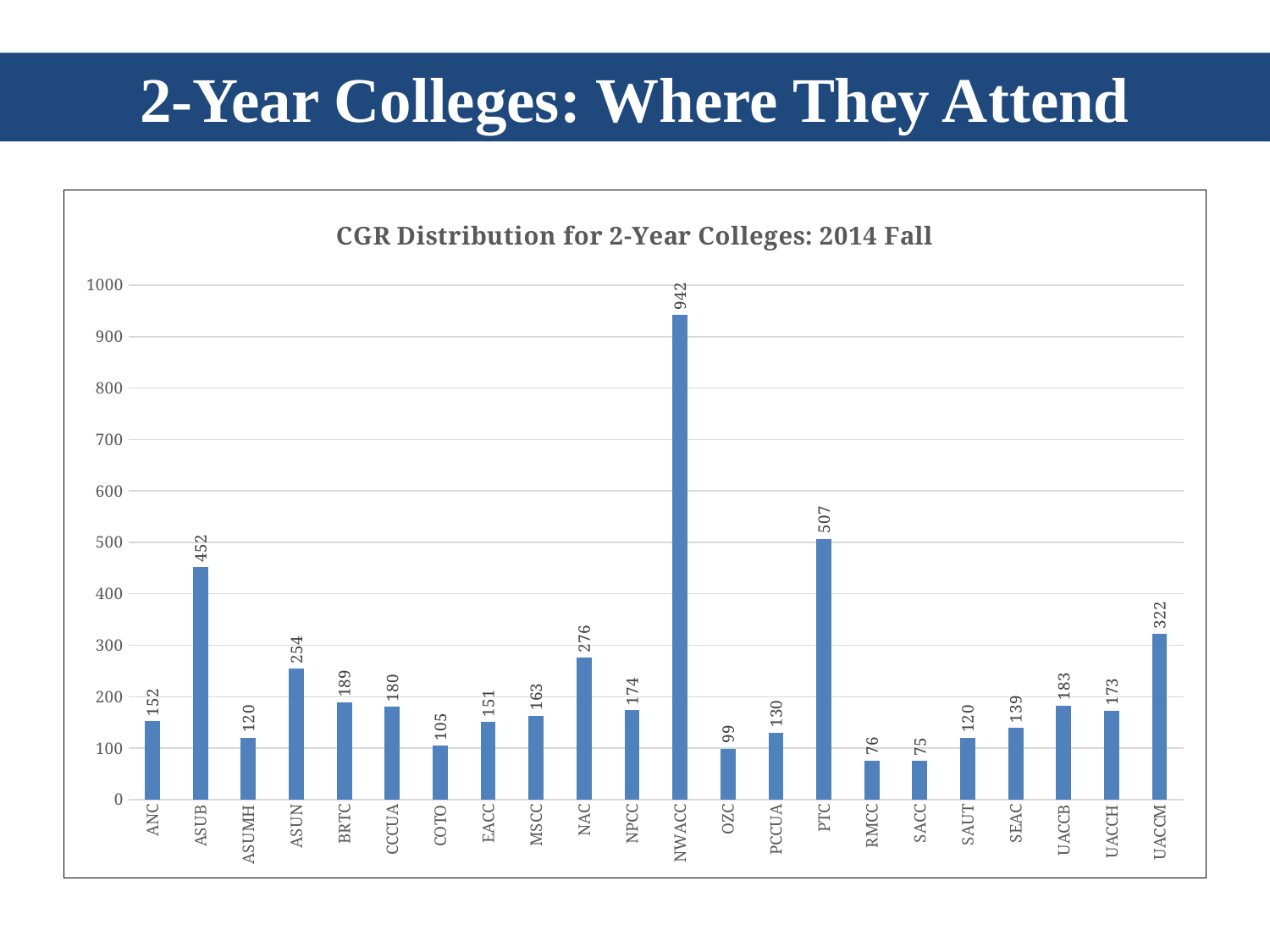
What is the value for ASUB? 452 Which is larger, the value for PTC or the value for ASUB? PTC What is the value for NWACC? 942 What kind of chart is shown? bar chart What is the difference between the values for ASUB and ASUN? 198 How many colleges are shown on the x axis? 22 What is the difference between the values for NWACC and PTC? 435 Is the value for COTO greater or less than 200? less Which college has the highest value? NWACC Which is larger, the value for NAC or the value for UACCM? UACCM What is the value for OZC? 99 What is the value for UACCM? 322